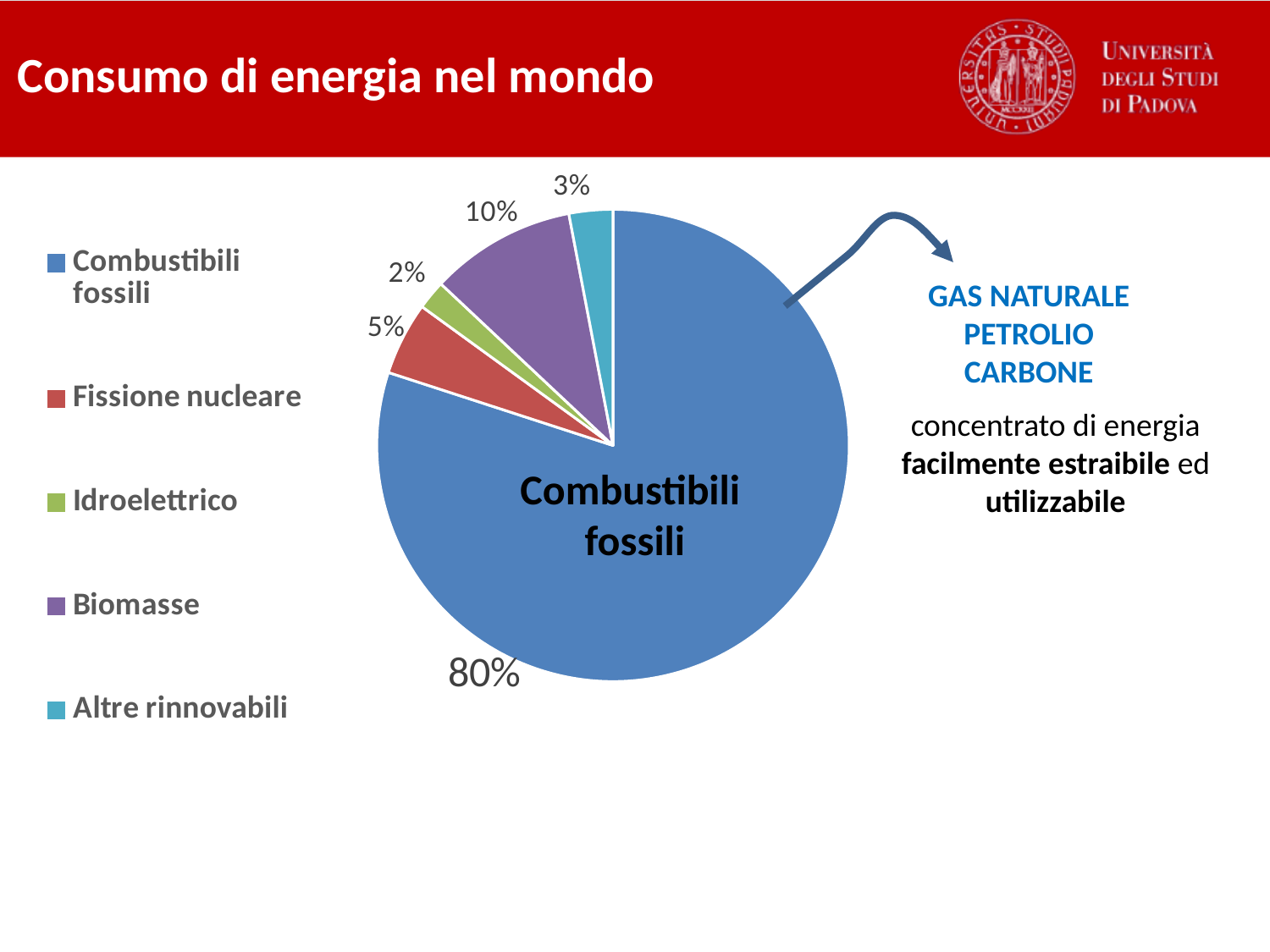
What share of the pie is Fissione nucleare? 5% What kind of chart is shown on the slide? pie chart What is the difference in percentage points between Combustibili fossili and Biomasse? 70 Which category has the smallest slice of the pie? Idroelettrico Which colour represents Altre rinnovabili in the pie chart? light blue (cyan) Which category has the largest slice of the pie? Combustibili fossili What share of the pie is Altre rinnovabili? 3% Which is larger, the share for Biomasse or the share for Fissione nucleare? Biomasse What share of the pie is Biomasse? 10% How many categories does the pie chart show? 5 What share of the pie is Idroelettrico? 2% What share of world energy consumption is Combustibili fossili? 80%